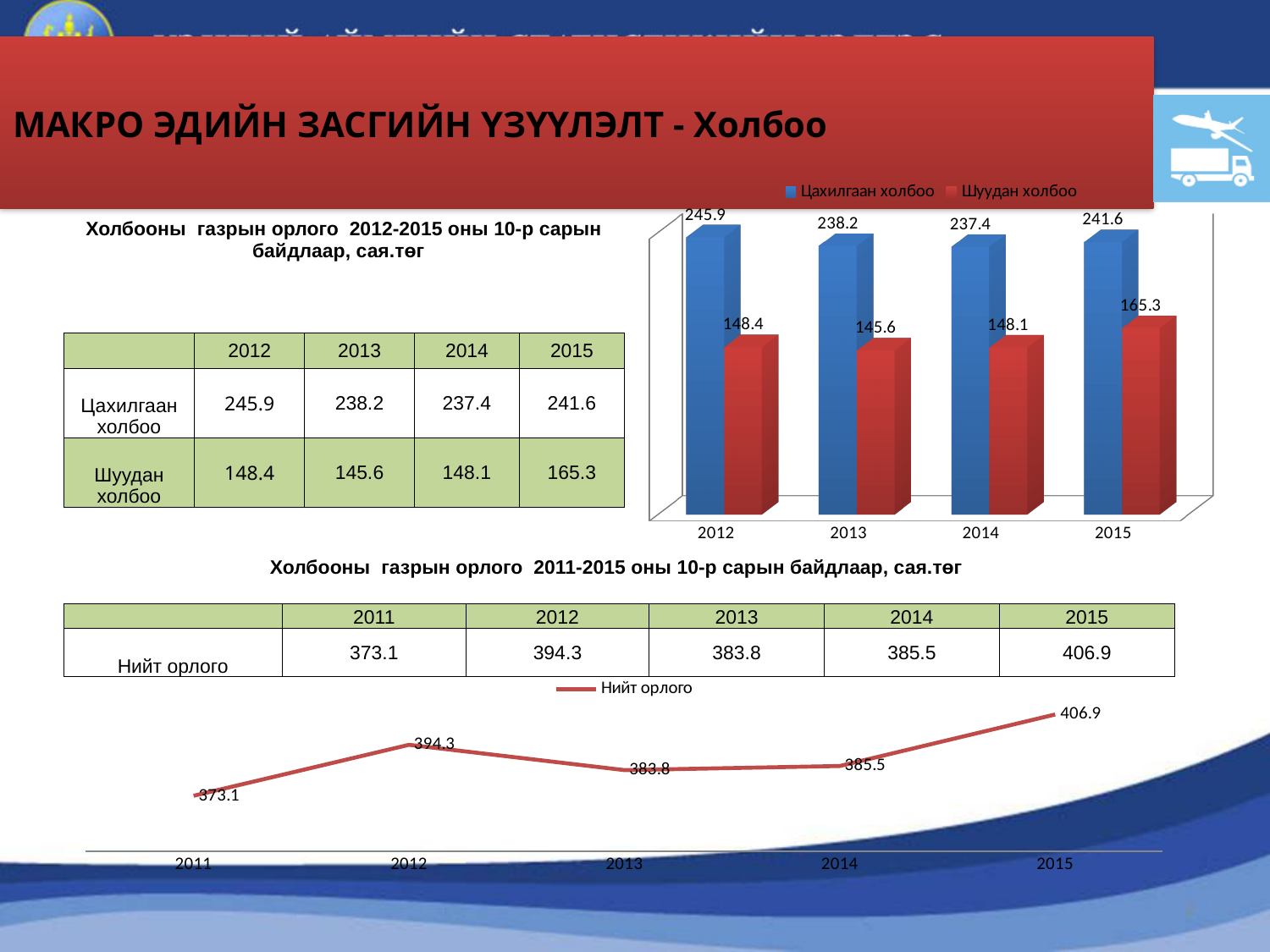
In the bar chart at the top right, which year has the lowest value for Цахилгаан холбоо? 2014 In the bar chart at the top right, what is the value for Цахилгаан холбоо in 2012? 245.9 In the line chart at the bottom, what is the value of Нийт орлого in 2011? 373.1 In the bar chart at the top right, how many series does the legend list? 2 In the bar chart at the top right, what is the value for Шуудан холбоо in 2015? 165.3 In the line chart at the bottom, is the value of Нийт орлого larger in 2012 or in 2013? 2012 In the line chart at the bottom, what is the difference in Нийт орлого between 2015 and 2014? 21.4 In the bar chart at the top right, which year has the highest value for Шуудан холбоо? 2015 In the line chart at the bottom, which year has the highest value of Нийт орлого? 2015 In the bar chart at the top right, how many years are shown on the x axis? 4 What kind of chart is shown at the top right of the slide? bar chart In the bar chart at the top right, what is the difference between Цахилгаан холбоо and Шуудан холбоо in 2013? 92.6